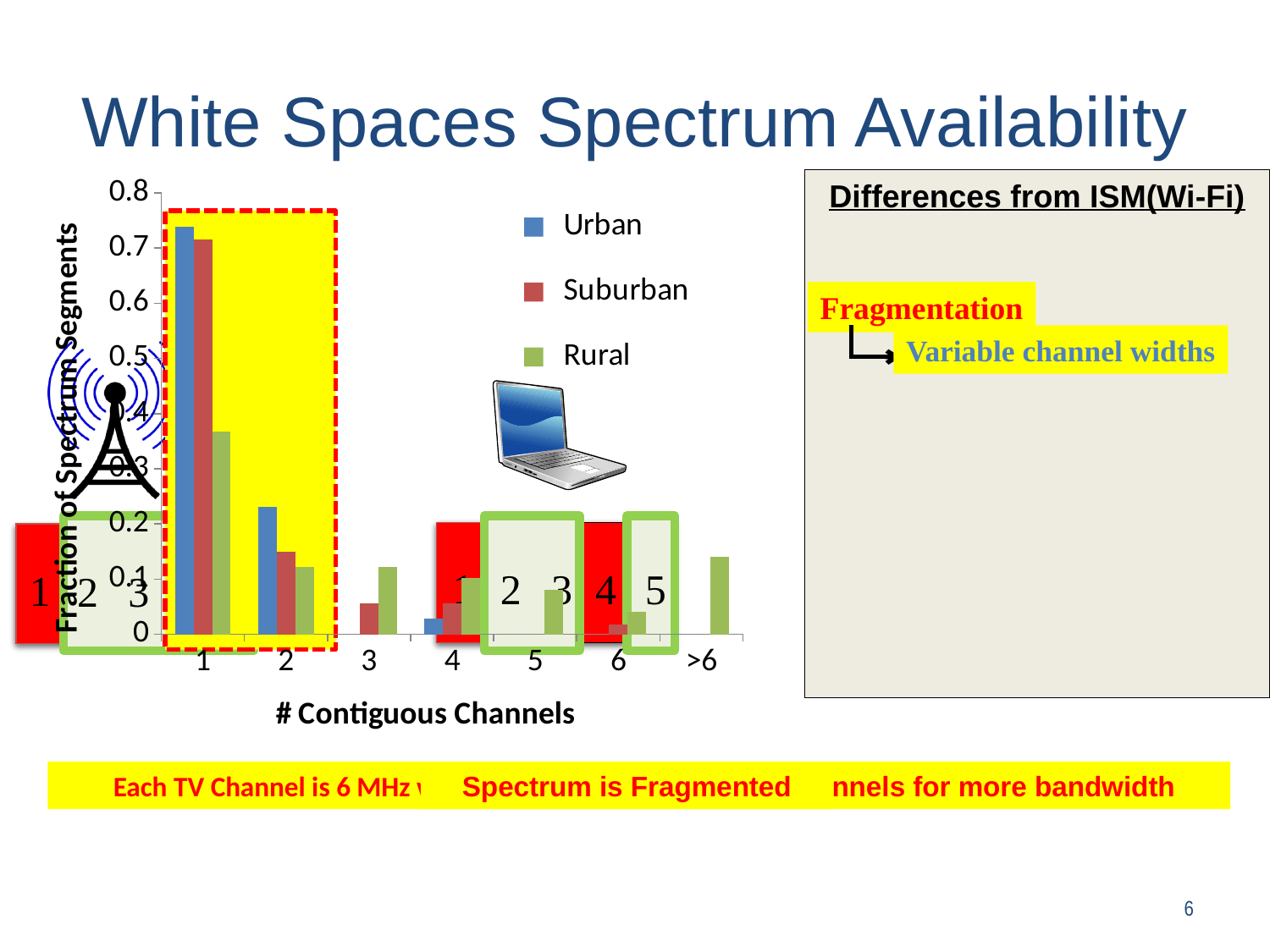
Is the Suburban value for 1 contiguous channel greater or less than 0.6? greater Which series are listed in the chart legend? Urban, Suburban, Rural What kind of chart is shown on the slide? bar chart For 1 contiguous channel, which is larger: the Urban value or the Rural value? Urban Is the Rural value for 1 contiguous channel greater or less than 0.4? less How many series does the chart legend list? 3 Is the Urban value for 1 contiguous channel greater or less than 0.7? greater How many categories are shown on the x axis of the chart? 7 What is the title of the x axis of the chart? # Contiguous Channels For which number of contiguous channels is the Urban value highest? 1